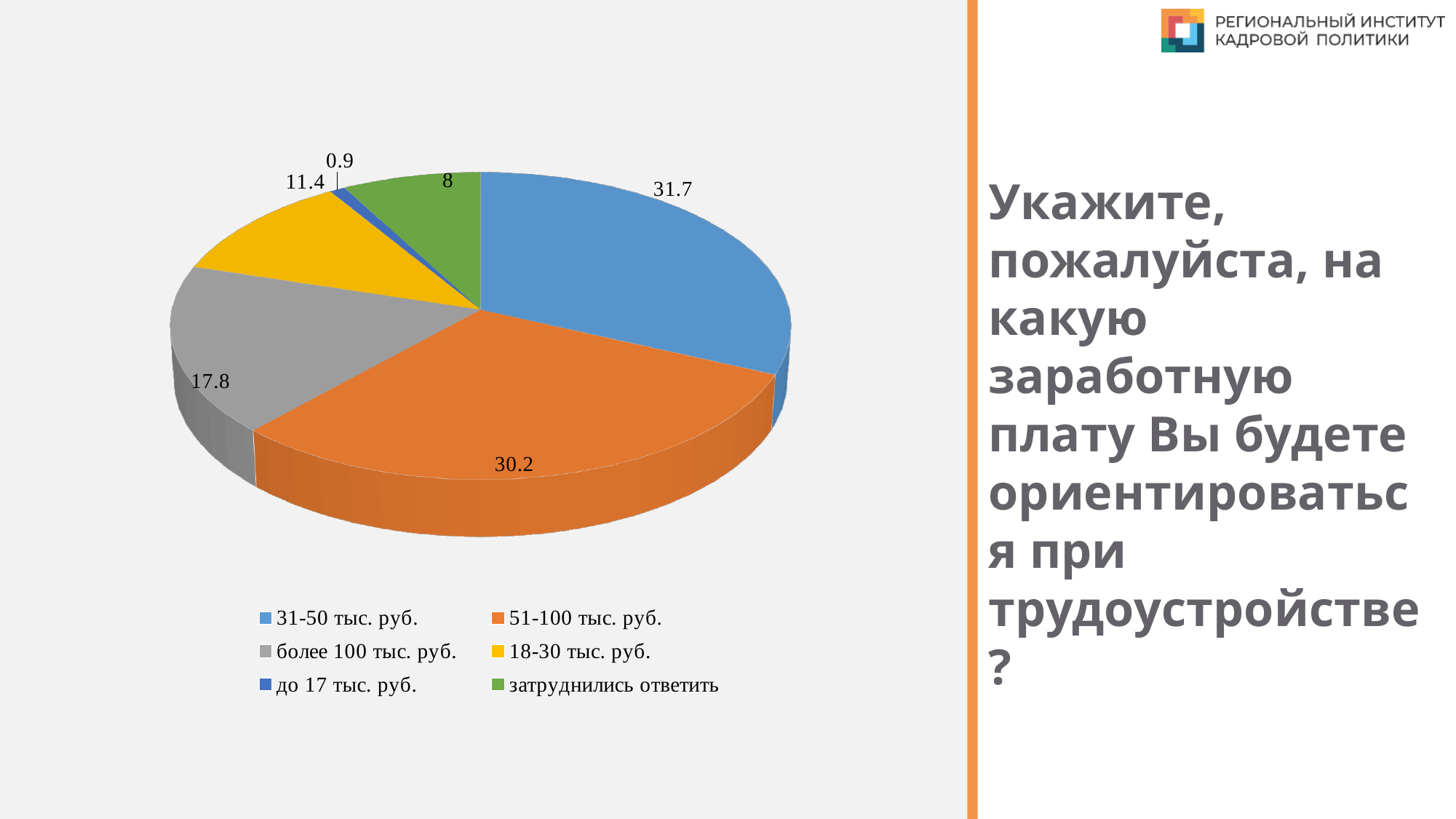
What colour is the "18-30 тыс. руб." slice? yellow What is the value for the "до 17 тыс. руб." slice? 0.9 What is the value for the "31-50 тыс. руб." slice? 31.7 What is the value for the "более 100 тыс. руб." slice? 17.8 What kind of chart is shown on the slide? pie chart How many categories does the pie chart have? 6 What is the value for the "затруднились ответить" slice? 8 Which category has the largest slice of the pie? 31-50 тыс. руб. What is the value for the "51-100 тыс. руб." slice? 30.2 Which is larger: the value for "18-30 тыс. руб." or the value for "затруднились ответить"? 18-30 тыс. руб. Which category has the smallest slice of the pie? до 17 тыс. руб. What is the difference between the values for "31-50 тыс. руб." and "51-100 тыс. руб."? 1.5